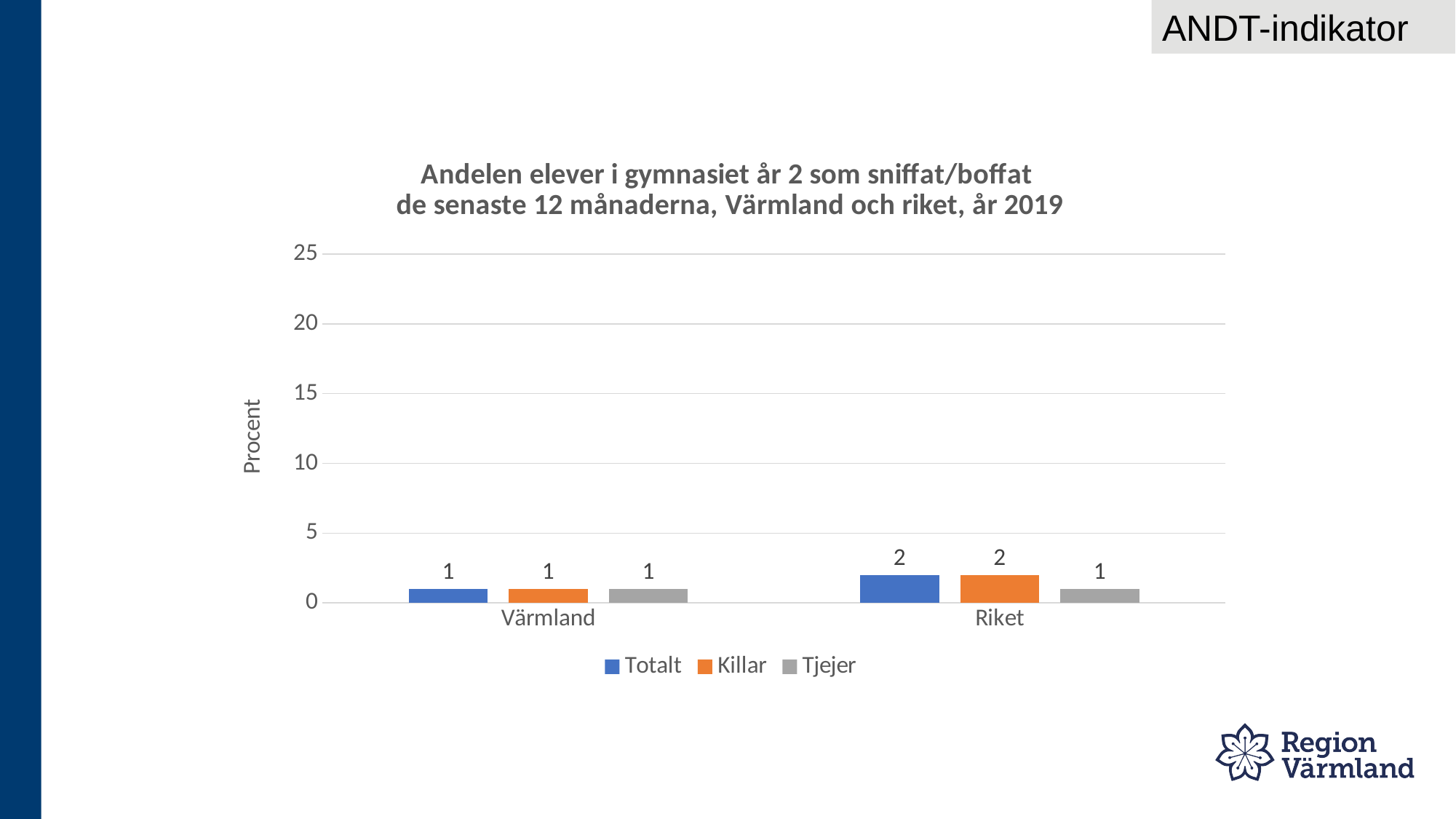
How many categories are shown on the x axis? 2 What is the value for Totalt in Värmland? 1 Is the value for Totalt in Riket greater or less than 5? less What is the difference between the Totalt value for Riket and the Totalt value for Värmland? 1 What kind of chart is shown on the slide? bar chart How many series does the legend list? 3 What is the label of the y axis? Procent Which colour represents the Killar series? orange What is the value for Killar in Riket? 2 What is the value for Tjejer in Riket? 1 Which is larger, the Killar value for Riket or the Killar value for Värmland? Riket What is the value for Killar in Värmland? 1